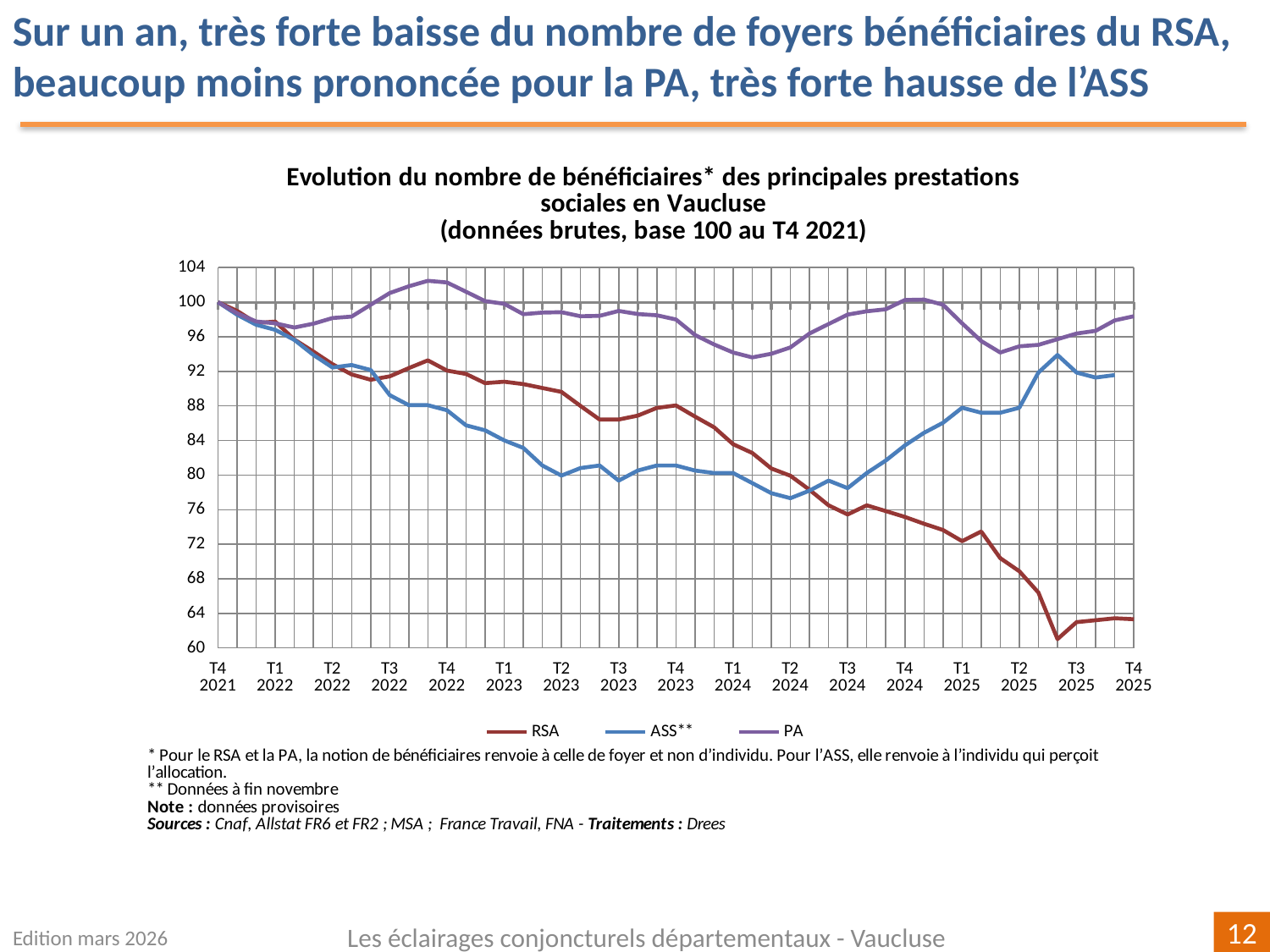
Is the value for PA at T4 2025 greater or less than 96? greater Does the RSA series rise or fall overall from T4 2021 to T4 2025? fall What kind of chart is shown on the slide? line chart Which series are listed in the legend? RSA, ASS**, PA Is the value for RSA at T4 2025 greater or less than 64? less What is the value of all three series at T4 2021? 100 Which series has the highest value at T4 2025? PA Which series has the lowest value at T4 2025? RSA At T4 2024, which is larger, the value for RSA or the value for ASS**? ASS** How many series does the legend list? 3